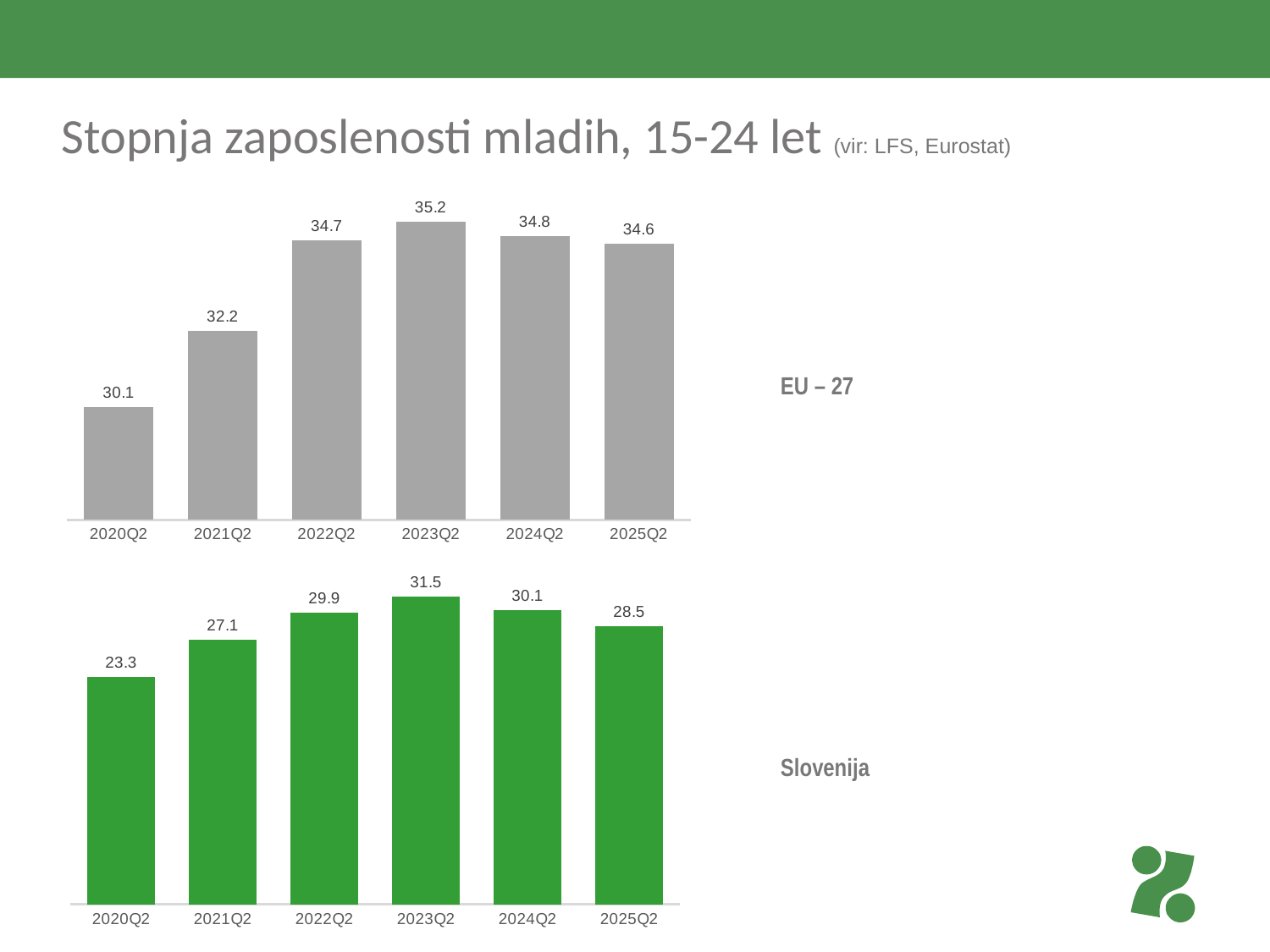
In the bottom chart (Slovenija), what is the difference between the values for 2023Q2 and 2025Q2? 3.0 What kind of chart is the bottom chart (Slovenija)? Bar chart In the top chart (EU – 27), what is the value for 2023Q2? 35.2 How many quarters are shown in the top chart (EU – 27)? 6 In the top chart (EU – 27), what is the difference between the values for 2021Q2 and 2020Q2? 2.1 In the bottom chart (Slovenija), what is the value for 2025Q2? 28.5 In the bottom chart (Slovenija), what is the value for 2020Q2? 23.3 What colour are the bars in the bottom chart (Slovenija)? Green In the bottom chart (Slovenija), which is larger, the value for 2022Q2 or the value for 2024Q2? 2022Q2 In the bottom chart (Slovenija), do the values rise or fall from 2020Q2 to 2023Q2? Rise In the bottom chart (Slovenija), which quarter has the lowest value? 2020Q2 In the top chart (EU – 27), which quarter has the highest value? 2023Q2